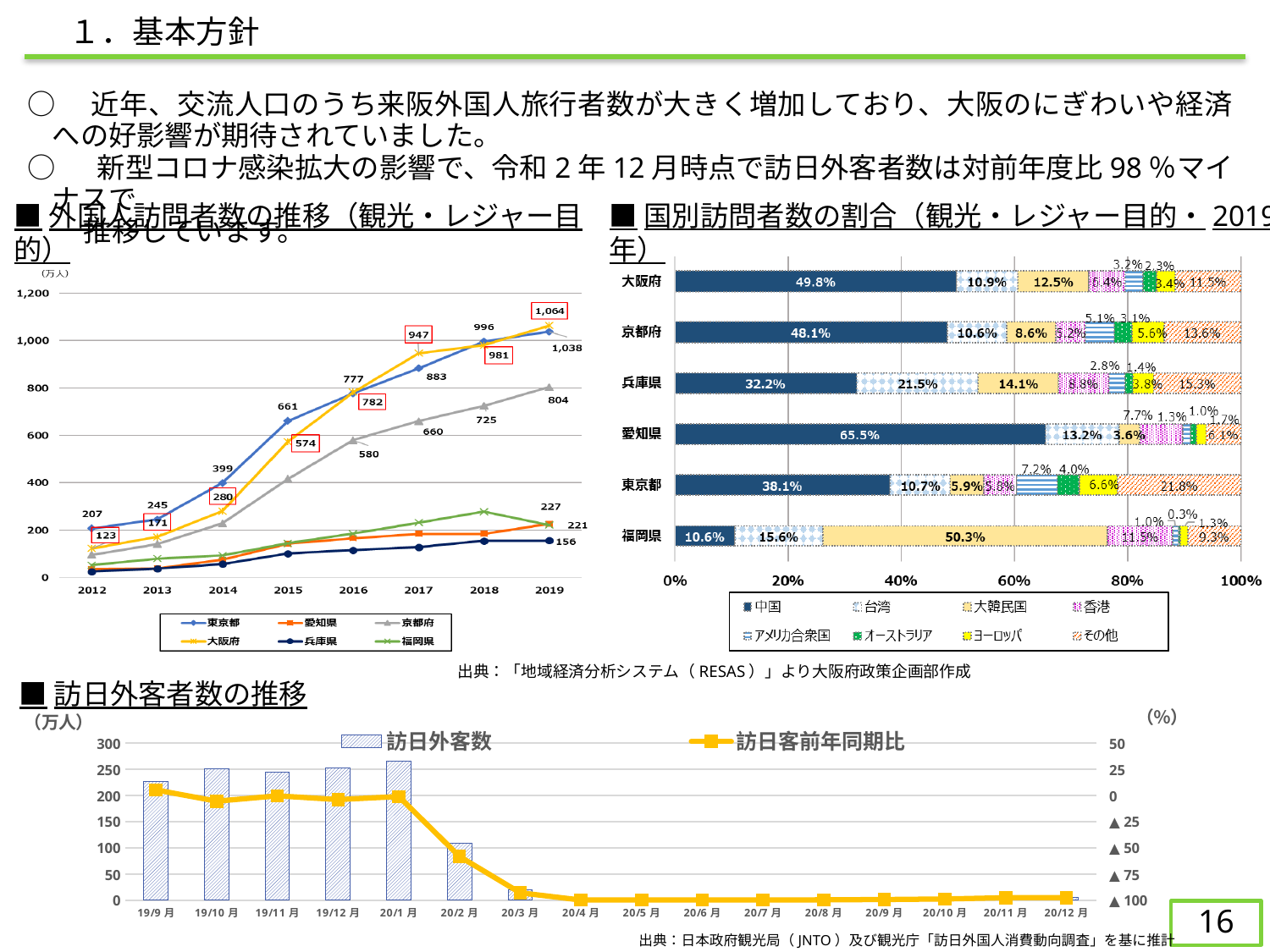
In the stacked bar chart titled 国別訪問者数の割合, which is larger: the 台湾 share for 兵庫県 or the 台湾 share for 大阪府? 兵庫県 In the line chart titled 外国人訪問者数の推移, what is the difference between the 大阪府 value in 2019 and its value in 2012? 941 In the chart titled 訪日外客者数の推移, is the 訪日外客数 bar for 20/1月 greater or less than 250? greater In the stacked bar chart titled 国別訪問者数の割合, which prefecture has the highest share of 中国? 愛知県 In the stacked bar chart titled 国別訪問者数の割合, how many prefectures are shown? 6 In the line chart titled 外国人訪問者数の推移, how many series does the legend list? 6 In the line chart titled 外国人訪問者数の推移, what is the value for 大阪府 in 2017? 947 In the stacked bar chart titled 国別訪問者数の割合, what is the share of 大韓民国 for 福岡県? 50.3% In the chart titled 訪日外客者数の推移, how many months are shown on the x axis? 16 In the line chart titled 外国人訪問者数の推移, does the 京都府 line rise or fall from 2016 to 2019? rise In the stacked bar chart titled 国別訪問者数の割合, what is the share of 中国 for 愛知県? 65.5% In the line chart titled 外国人訪問者数の推移, what is the value for 東京都 in 2019? 1,038